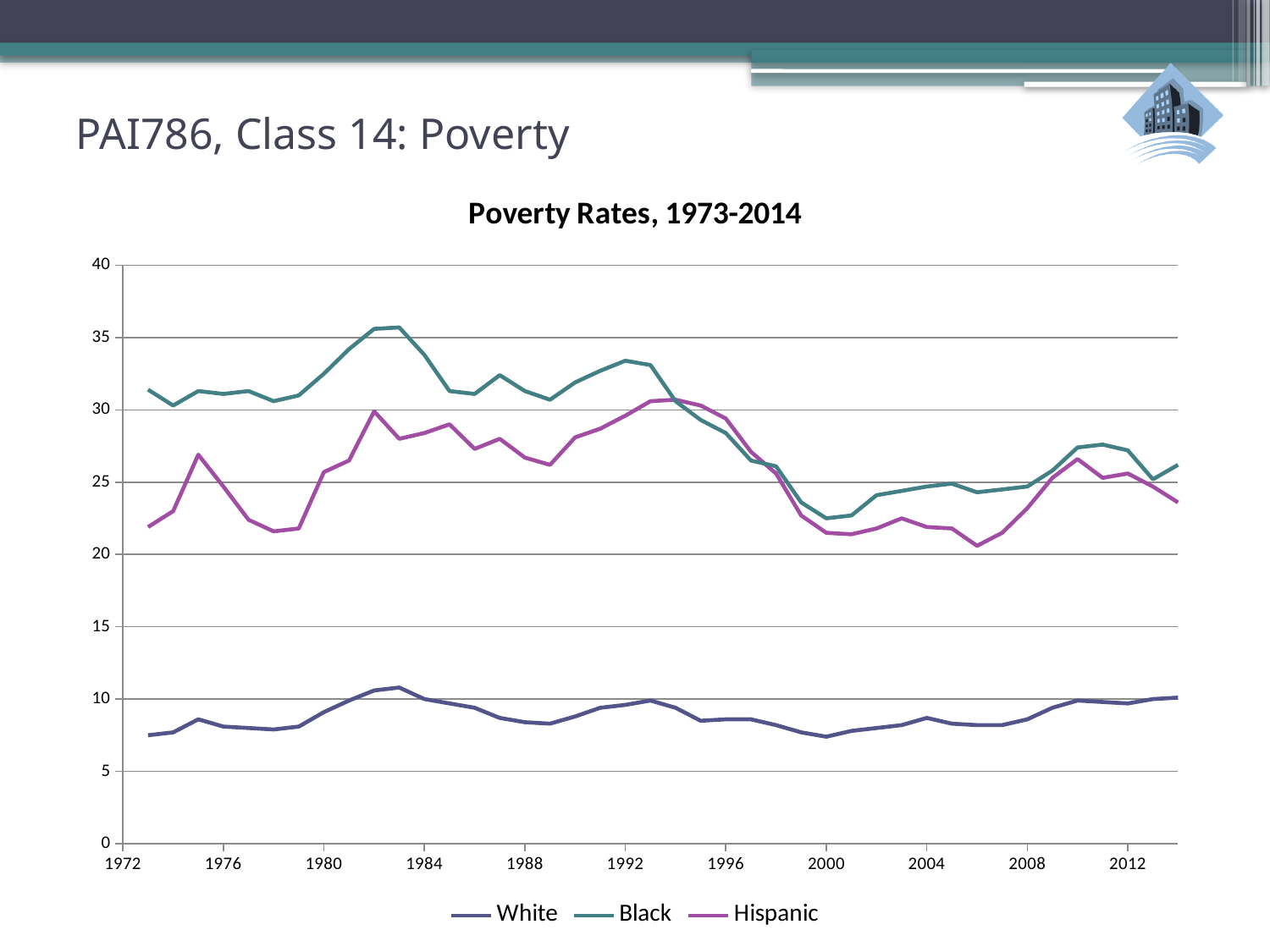
Is the value for Hispanic in 1975 greater or less than 25? greater What kind of chart is shown on the slide? line chart Is the value for White in 2000 greater or less than 10? less Is the value for Black in 2000 greater or less than 25? less What is the title of the chart? Poverty Rates, 1973-2014 Which series has the lowest poverty rate throughout the period? White How many series does the legend list? 3 Which series are listed in the legend? White, Black, Hispanic Which series has the highest poverty rate across most of the period? Black Does the Black poverty rate rise or fall between 1993 and 2000? fall In 1982, which is larger, the value for Black or the value for Hispanic? Black